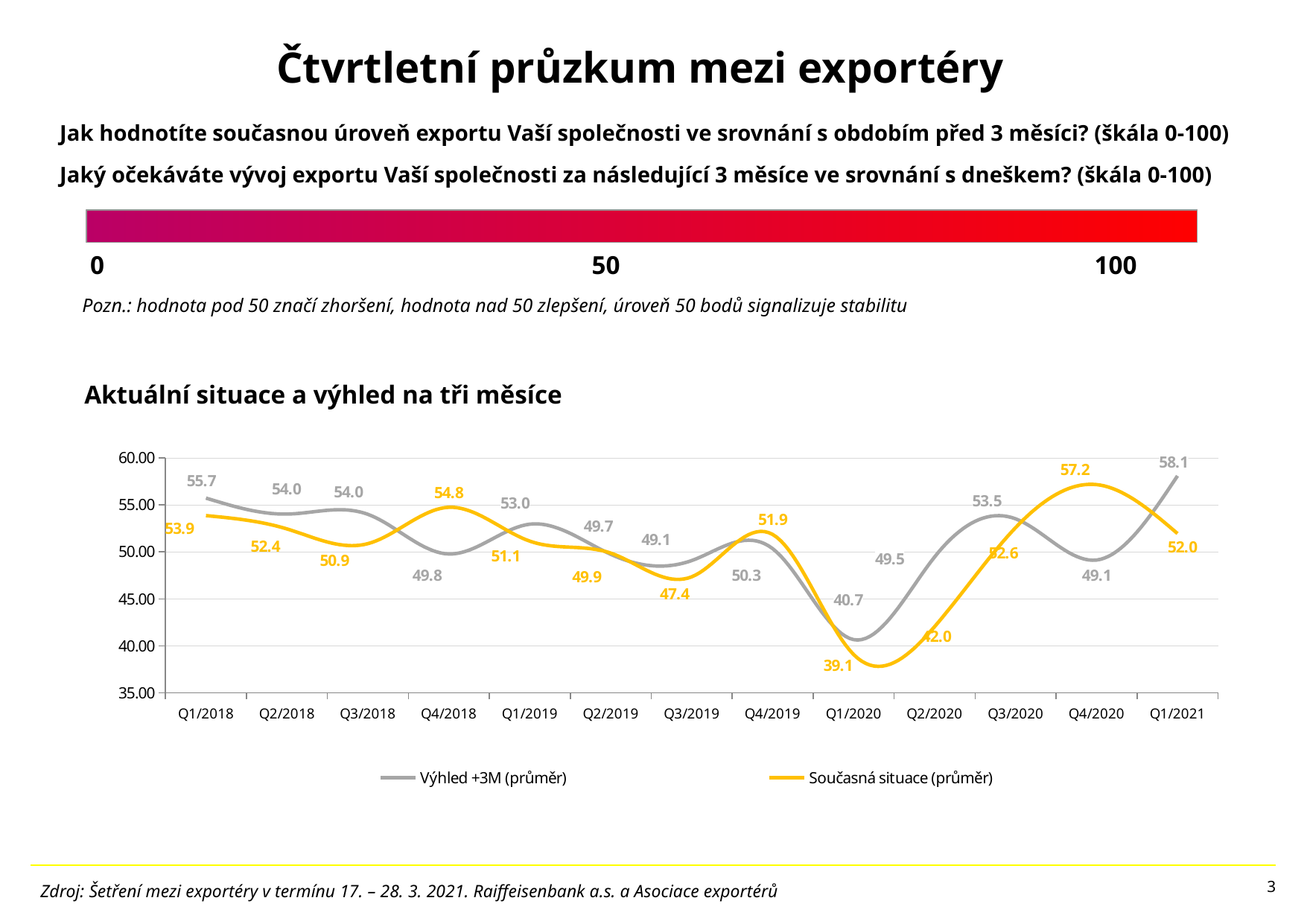
In which quarter does 'Výhled +3M (průměr)' reach its highest value? Q1/2021 How many quarters are shown on the x axis of the chart? 13 What is the value of 'Současná situace (průměr)' in Q4/2020? 57.2 In which quarter does 'Současná situace (průměr)' reach its lowest value? Q1/2020 How many series does the legend of the chart list? 2 What is the value of 'Výhled +3M (průměr)' in Q1/2020? 40.7 Which series has the higher value in Q1/2021, 'Výhled +3M (průměr)' or 'Současná situace (průměr)'? Výhled +3M (průměr) What type of chart is shown under the heading 'Aktuální situace a výhled na tři měsíce'? line chart What colour is the line for 'Současná situace (průměr)'? yellow What is the difference between 'Současná situace (průměr)' and 'Výhled +3M (průměr)' in Q4/2020? 8.1 Is the value of 'Současná situace (průměr)' in Q2/2020 greater or less than 45.00? less What is the value of 'Současná situace (průměr)' in Q3/2019? 47.4